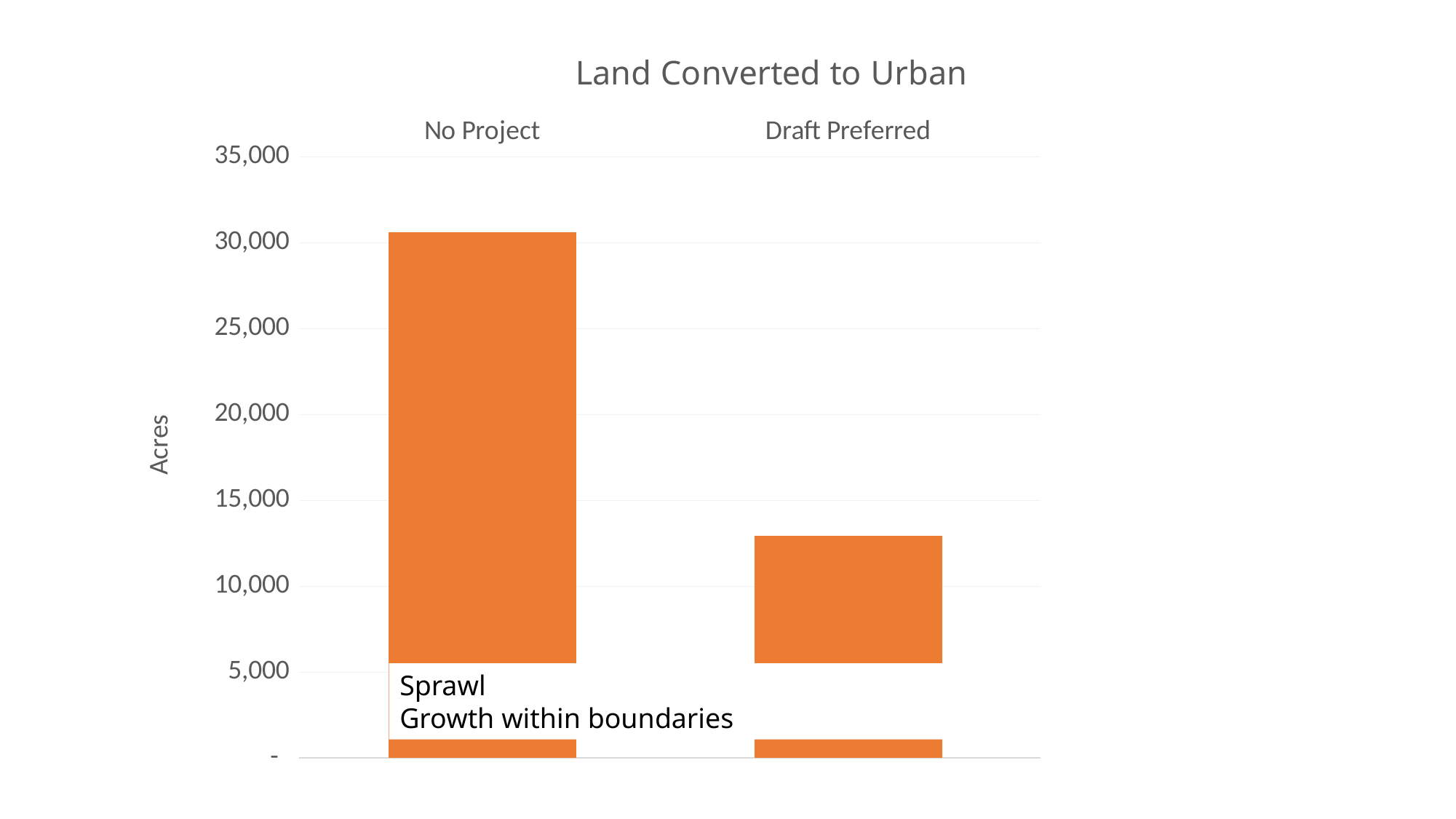
What is the label on the vertical axis of the chart? Acres Do the values rise or fall from No Project to Draft Preferred? fall How many categories are plotted in the chart? 2 Is the value for No Project greater or less than 35,000? less Which is larger, the value for No Project or the value for Draft Preferred? No Project What kind of chart is shown on the slide? bar chart Is the value for No Project greater or less than 30,000? greater Which category has the lowest value in the chart? Draft Preferred Is the value for Draft Preferred greater or less than 10,000? greater What is the title of the chart? Land Converted to Urban Which category has the highest value in the chart? No Project